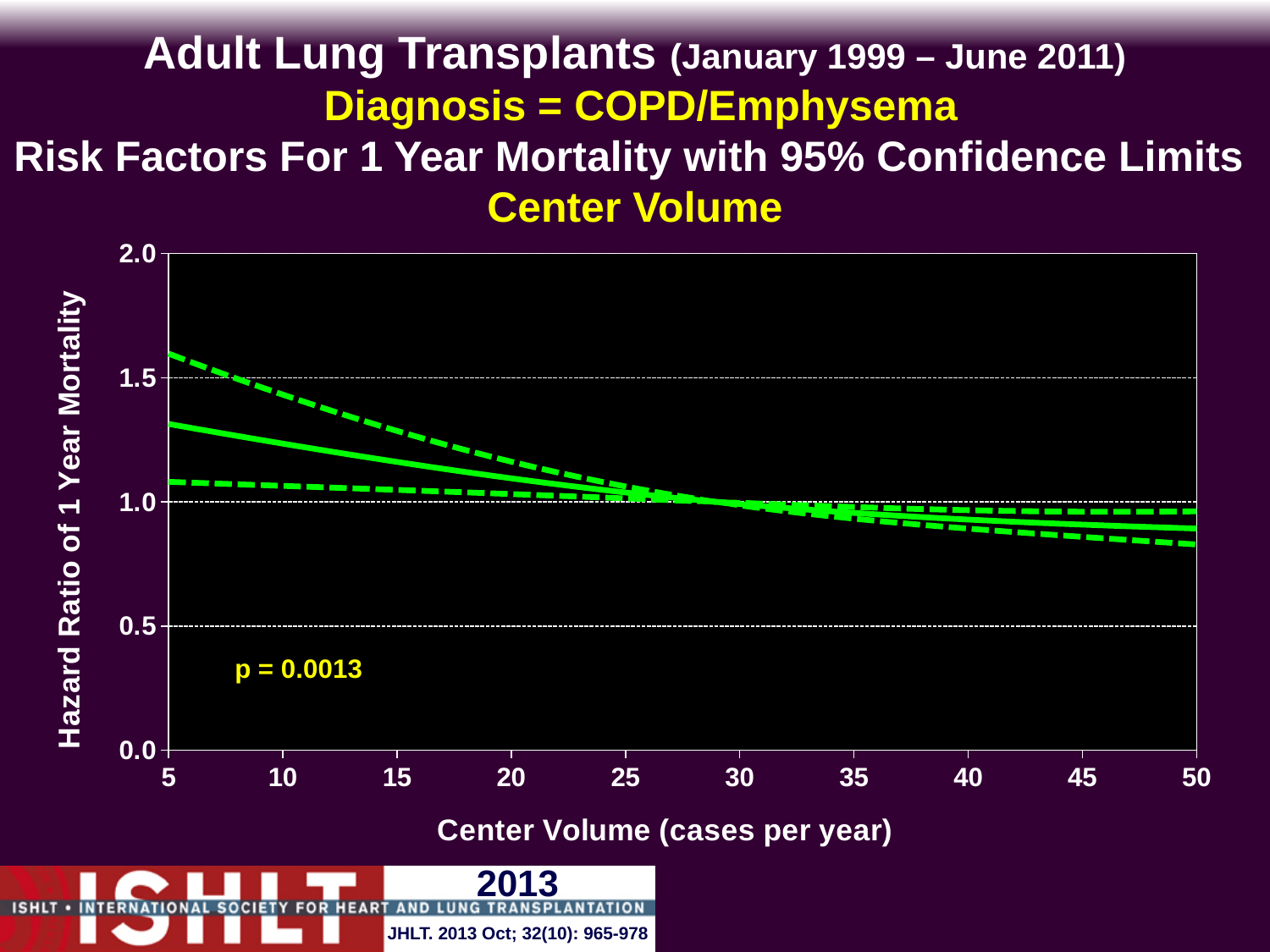
Which is larger: the hazard ratio (solid line) at a center volume of 5 or at a center volume of 45 cases per year? 5 Is the upper 95% confidence limit at a center volume of 5 cases per year greater or less than 1.5? greater What is the label of the x axis? Center Volume (cases per year) Is the hazard ratio (solid line) at a center volume of 15 cases per year greater or less than 1.5? less Is the hazard ratio (solid line) at a center volume of 50 cases per year greater or less than 1.0? less What p-value is printed on the chart? p = 0.0013 What kind of chart is shown on the slide? line chart Does the solid hazard ratio line rise or fall as center volume increases from 5 to 50 cases per year? fall How many lines are plotted on the chart? 3